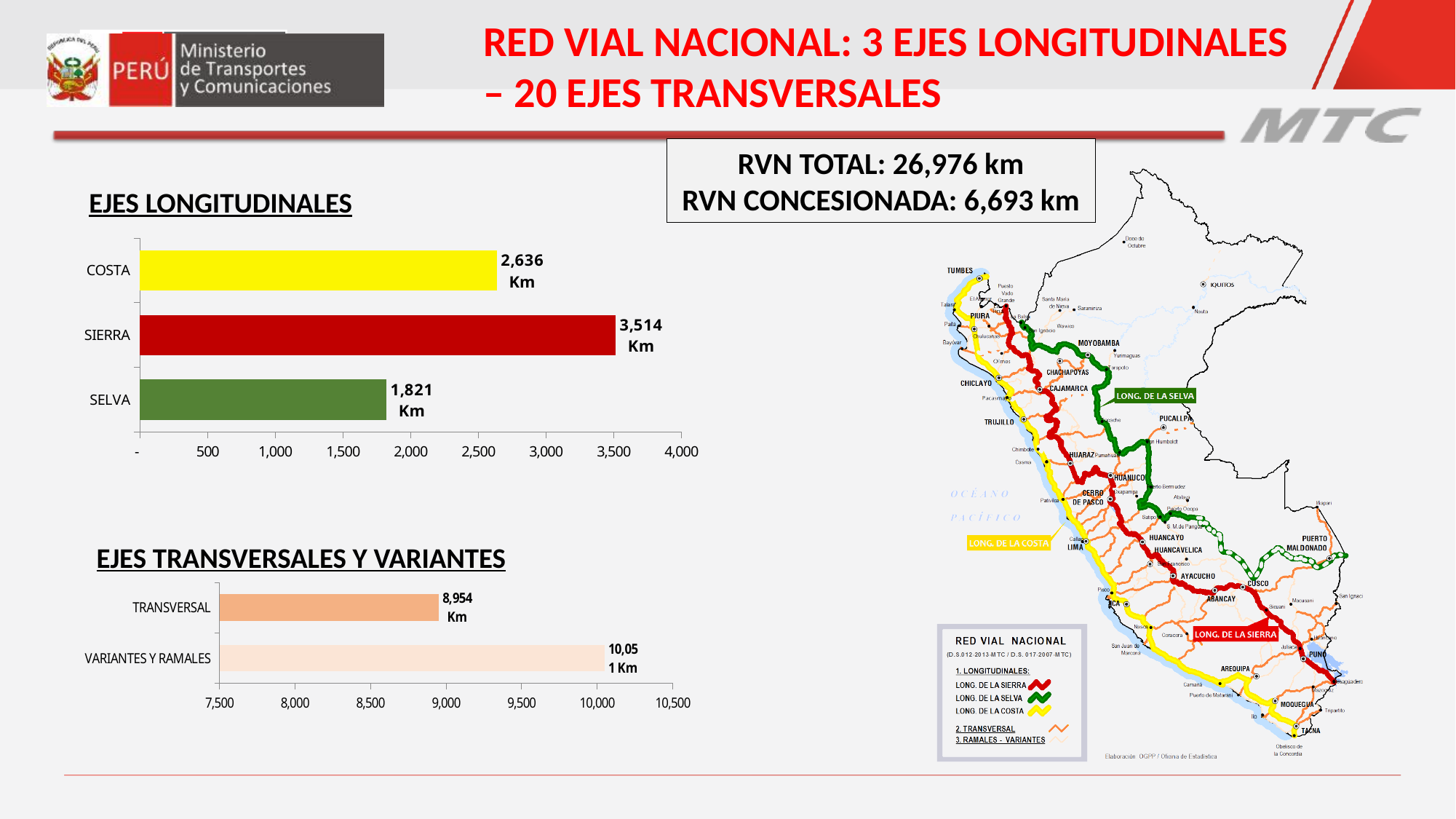
In the EJES LONGITUDINALES chart, which category has the highest value? SIERRA What type of chart is the EJES LONGITUDINALES chart? Bar chart In the EJES TRANSVERSALES Y VARIANTES chart, what is the value for VARIANTES Y RAMALES? 10,051 Km In the EJES LONGITUDINALES chart, what is the value for SIERRA? 3,514 Km In the EJES TRANSVERSALES Y VARIANTES chart, what is the value for TRANSVERSAL? 8,954 Km In the EJES LONGITUDINALES chart, what is the value for SELVA? 1,821 Km In the EJES LONGITUDINALES chart, what is the difference between the values for SIERRA and COSTA? 878 Km In the EJES TRANSVERSALES Y VARIANTES chart, what is the difference between VARIANTES Y RAMALES and TRANSVERSAL? 1,097 Km In the EJES LONGITUDINALES chart, how many categories are shown? 3 In the EJES TRANSVERSALES Y VARIANTES chart, which is larger, TRANSVERSAL or VARIANTES Y RAMALES? VARIANTES Y RAMALES In the EJES LONGITUDINALES chart, which category has the lowest value? SELVA In the EJES LONGITUDINALES chart, what colour is the bar for COSTA? Yellow